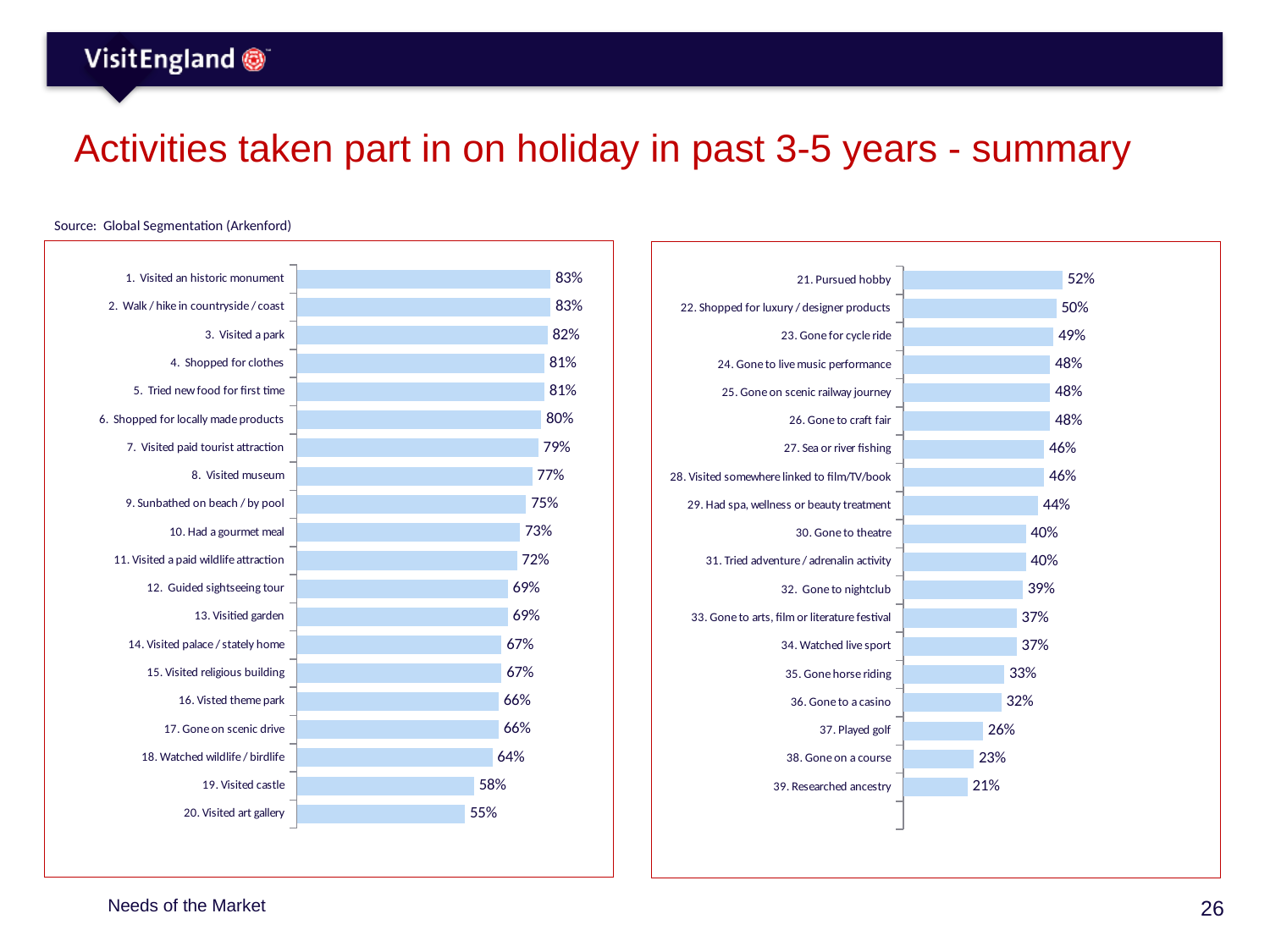
What type of chart is used on the left side of the slide? Bar chart How many activities are listed in the right chart? 19 In the left chart, what is the value for '19. Visited castle'? 58% In the right chart, which is larger: '35. Gone horse riding' or '36. Gone to a casino'? 35. Gone horse riding In the right chart, which activity has the highest percentage? 21. Pursued hobby In the left chart, what is the difference in percentage points between '1. Visited an historic monument' and '20. Visited art gallery'? 28 In the left chart, what percentage is shown for '8. Visited museum'? 77% How many activities are listed in the left chart? 20 In the left chart, which activity has the lowest percentage? 20. Visited art gallery In the right chart, what percentage is shown for '30. Gone to theatre'? 40% In the right chart, what is the difference in percentage points between '21. Pursued hobby' and '37. Played golf'? 26 In the right chart, which activity has the lowest percentage? 39. Researched ancestry